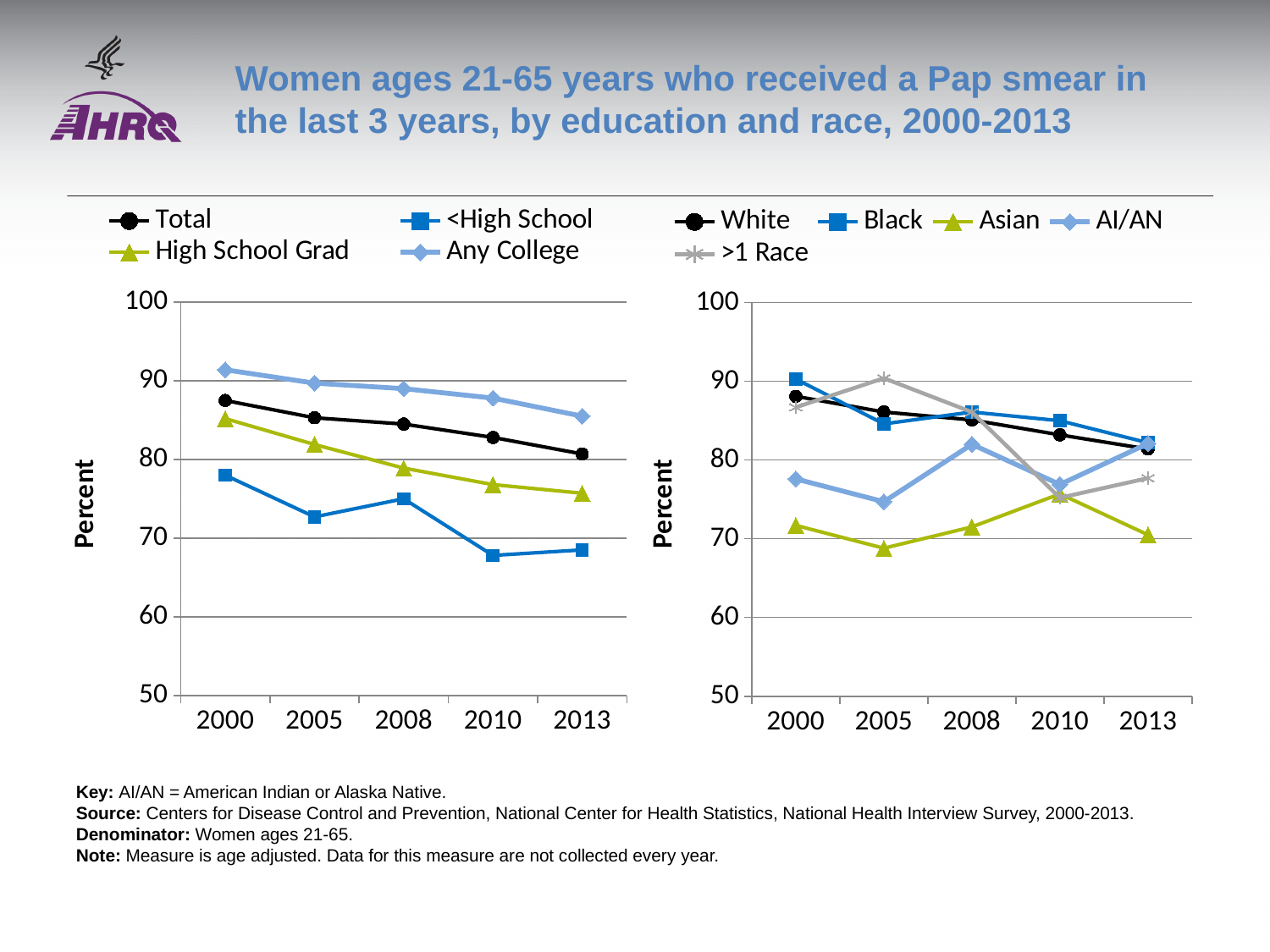
In the left chart (by education), is the value for <High School in 2010 greater or less than 70? less In the right chart (by race), which is larger in 2000, the value for Black or the value for Asian? Black What is the label on the y axis of the right chart (by race)? Percent How many years are plotted on the x axis of the left chart (by education)? 5 In the left chart (by education), which series has the highest value in 2000? Any College In the left chart (by education), is the value for Any College in 2000 greater or less than 90? greater How many series does the legend of the right chart (by race) list? 5 What type of chart is the left chart (by education)? Line chart In the right chart (by race), which series has the lowest value in 2013? Asian In the left chart (by education), which series has the lowest value in 2013? <High School In the right chart (by race), is the value for Asian in 2005 greater or less than 70? less In the left chart (by education), does the Total series rise or fall from 2000 to 2013? Fall